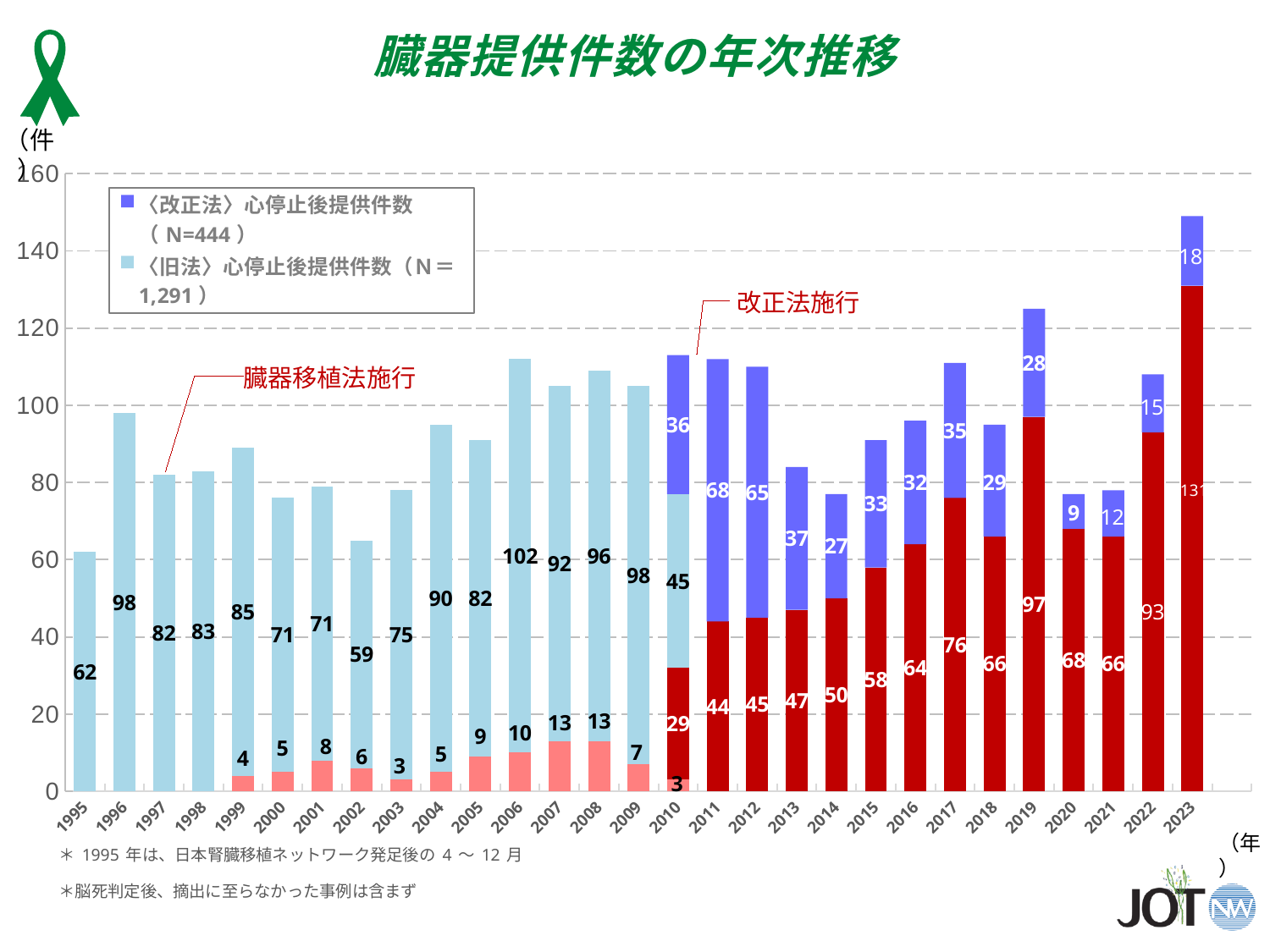
Is the total for 2023 greater or less than 140? greater What kind of chart is shown on the slide? bar chart Which year has the tallest bar overall? 2023 How many years are shown along the x axis? 29 What is the value labelled on the upper (blue) segment of the 2019 bar? 28 How many series does the legend list? 2 Which is larger, the dark red segment for 2017 or the dark red segment for 2018? 2017 What is the difference between the dark red segment values for 2019 (97) and 2020 (68)? 29 What is the total of the stacked bar for 2023 (18 + 131)? 149 What is the value labelled on the bar for 1996? 98 What is the value labelled on the lower (dark red) segment of the 2023 bar? 131 What is the total of the stacked bar for 2011 (68 + 44)? 112